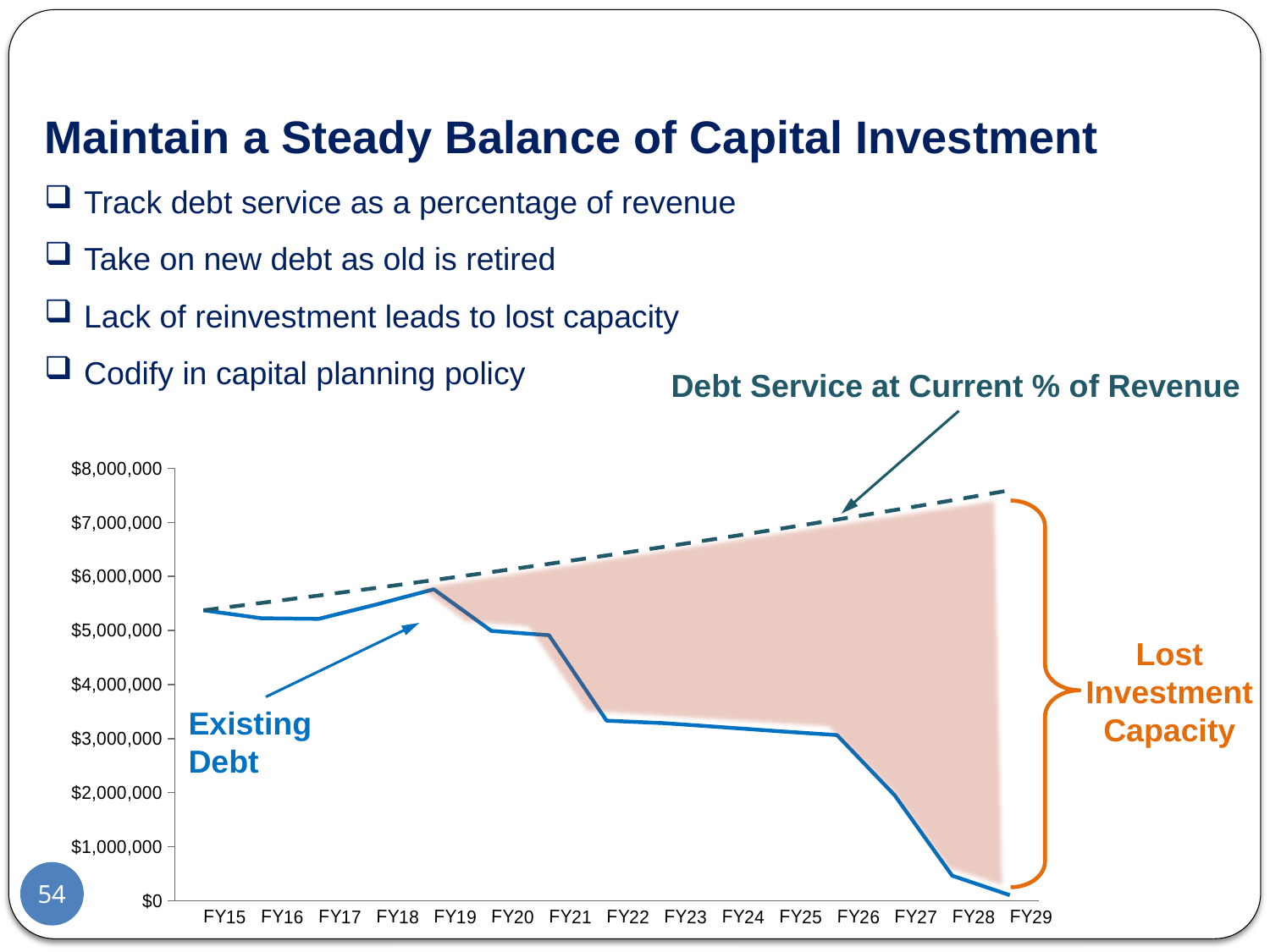
Does the Debt Service at Current % of Revenue line rise or fall from FY15 to FY29? rise Is the Debt Service at Current % of Revenue value for FY29 greater or less than $7,000,000? greater In which fiscal year is the Existing Debt line at its lowest value? FY29 How many fiscal years are shown on the x axis of the chart? 15 In which fiscal year does the Existing Debt line reach its highest value? FY19 Is the Existing Debt value for FY15 greater or less than $5,000,000? greater Is the Existing Debt value for FY22 greater or less than $3,000,000? greater What kind of chart is shown on the slide? line chart In FY29, which is larger: Existing Debt or Debt Service at Current % of Revenue? Debt Service at Current % of Revenue How many data series are plotted on the chart? 2 What label is given to the shaded gap between the two lines on the chart? Lost Investment Capacity